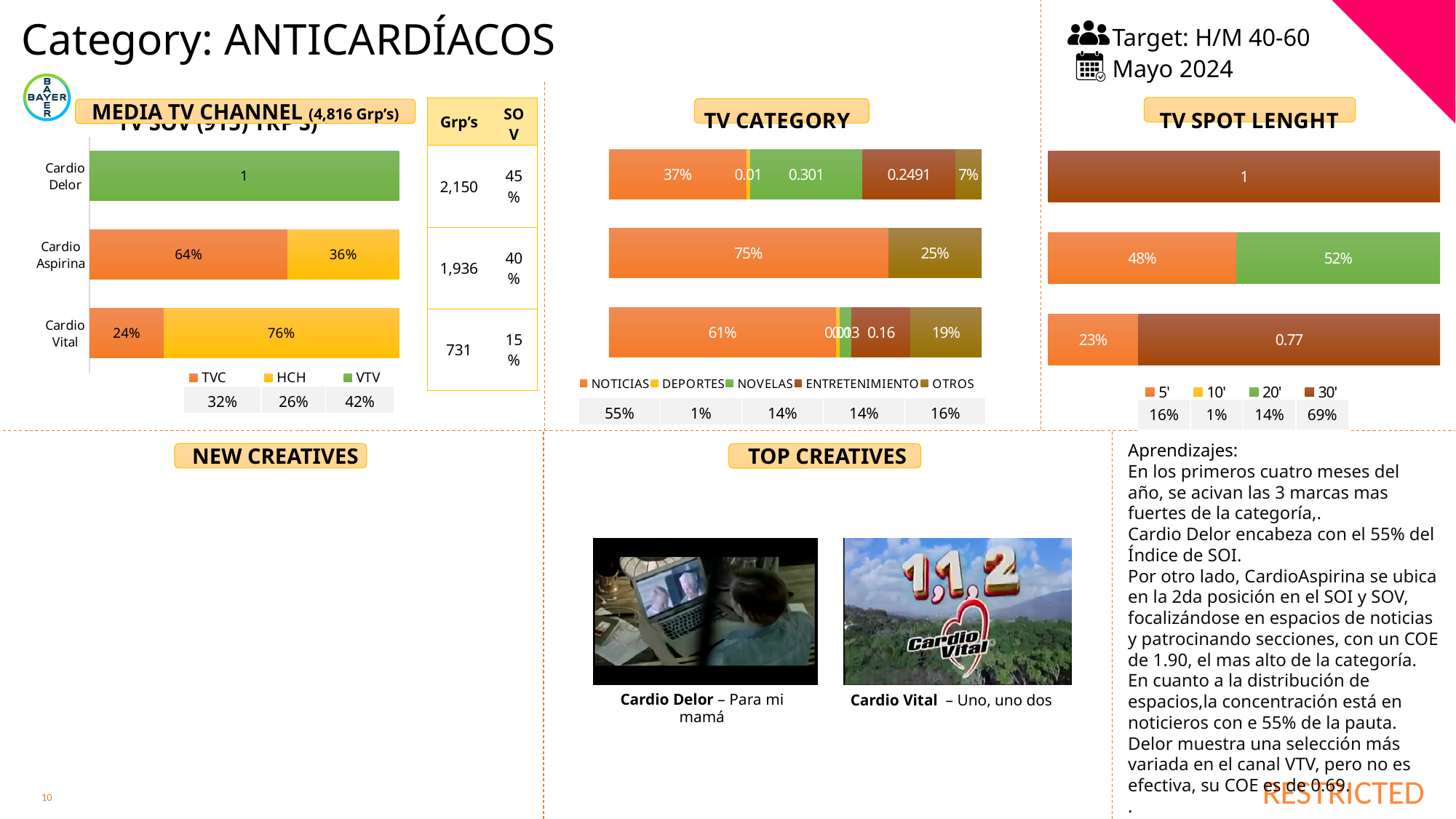
In the MEDIA TV CHANNEL chart, which brand has the larger TVC share, Cardio Aspirina or Cardio Vital? Cardio Aspirina In the TV SPOT LENGHT chart, what is the 20' value for the middle bar? 52% In the MEDIA TV CHANNEL chart, what is the HCH value for Cardio Vital? 76% What kind of chart is the TV CATEGORY chart? Stacked bar chart How many series does the legend of the TV CATEGORY chart list? 5 In the MEDIA TV CHANNEL chart, what is the TVC value for Cardio Aspirina? 64% In the TV CATEGORY chart, what is the NOTICIAS value for the middle bar? 75% In the MEDIA TV CHANNEL chart, what is the difference between the HCH value for Cardio Vital and the HCH value for Cardio Aspirina? 40% In the TV CATEGORY chart, what is the OTROS value for the bottom bar? 19% In the TV SPOT LENGHT chart, what is the 5' value for the bottom bar? 23% How many series does the legend of the MEDIA TV CHANNEL chart list? 3 How many brands are shown on the MEDIA TV CHANNEL chart? 3